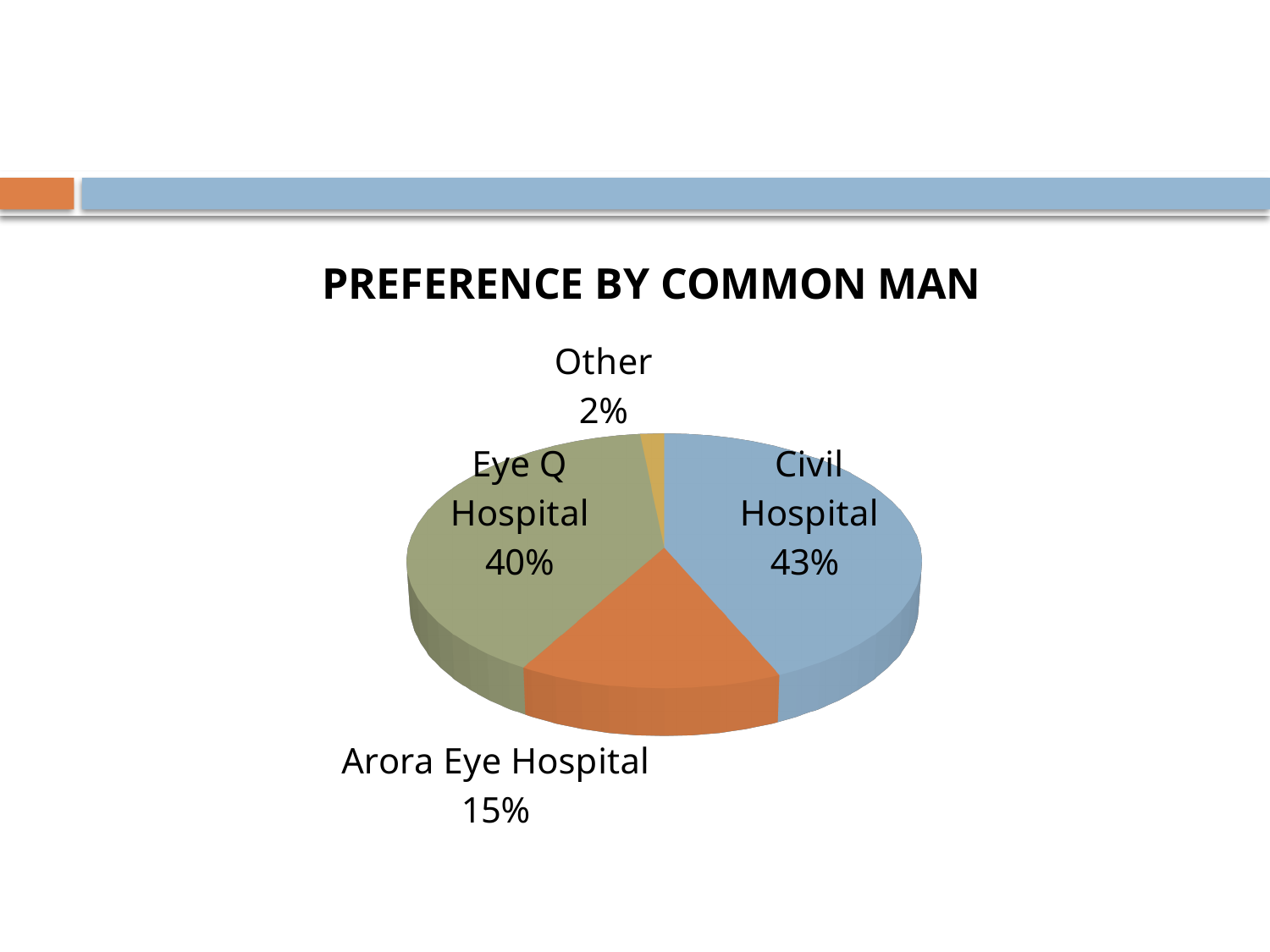
Which category has the largest share of the pie? Civil Hospital What is the difference in percentage points between Eye Q Hospital and Arora Eye Hospital? 25 What percentage is shown for Eye Q Hospital? 40% What kind of chart is shown on the slide? Pie chart What share of the pie does Civil Hospital have? 43% How many slices does the pie chart have? 4 Which category has the smallest share of the pie? Other What share does the Other slice have? 2% What is the difference in percentage points between Civil Hospital and Eye Q Hospital? 3 What percentage is shown for Arora Eye Hospital? 15% Which is larger, the share for Arora Eye Hospital or the share for Other? Arora Eye Hospital What is the title of the chart? PREFERENCE BY COMMON MAN